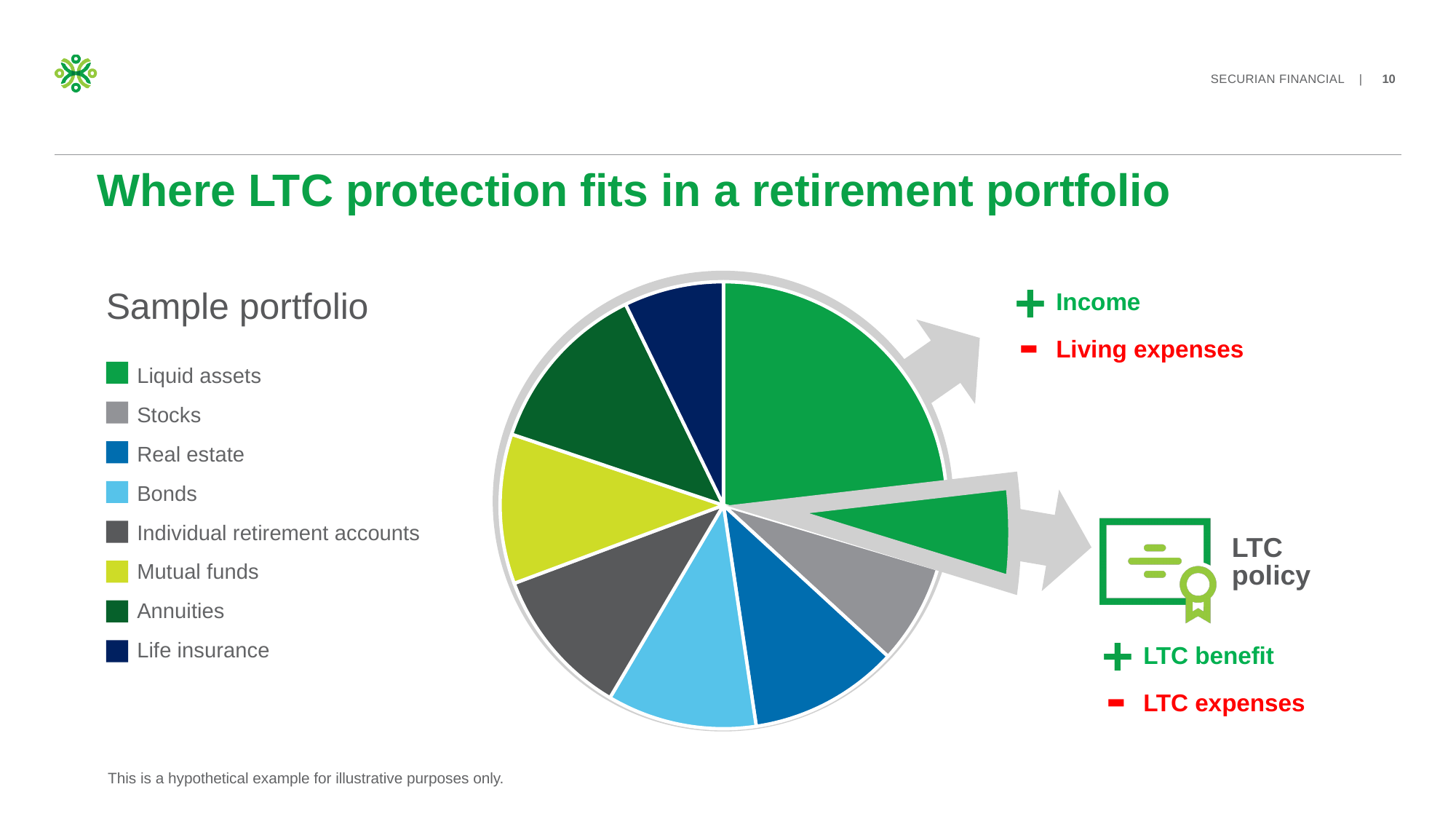
What is the title of the slide containing the pie chart? Where LTC protection fits in a retirement portfolio Which slice is larger, Liquid assets or Life insurance? Liquid assets Which slice is larger, Mutual funds or Life insurance? Mutual funds What kind of chart is shown on the slide? pie chart What does the small exploded slice of the pie chart point to? LTC policy How many categories does the legend of the pie chart list? 8 Which slice is larger, Liquid assets or Bonds? Liquid assets Which category has the largest slice of the pie chart? Liquid assets